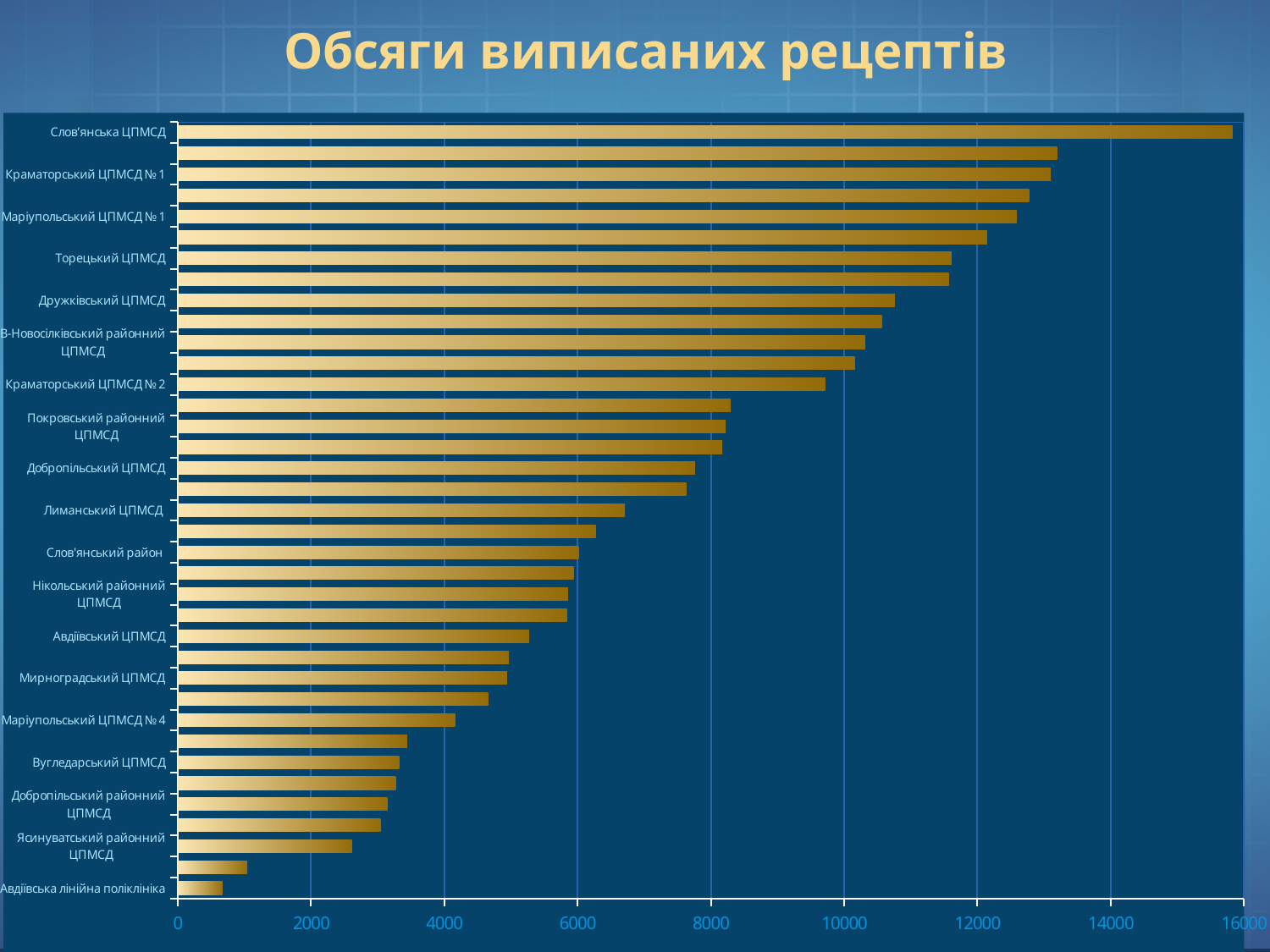
Which is larger, the value for Краматорський ЦПМСД № 1 or the value for Дружківський ЦПМСД? Краматорський ЦПМСД № 1 What kind of chart is shown on the slide? bar chart Is the value for Лиманський ЦПМСД greater or less than 8000? less Is the value for Торецький ЦПМСД greater or less than 10000? greater What is the largest value shown on the horizontal axis? 16000 Which category has the highest value? Слов'янська ЦПМСД What is the title of the chart? Обсяги виписаних рецептів Is the value for Авдіївська лінійна поліклініка greater or less than 2000? less Which is larger, the value for Вугледарський ЦПМСД or the value for Авдіївський ЦПМСД? Авдіївський ЦПМСД Which category has the lowest value? Авдіївська лінійна поліклініка